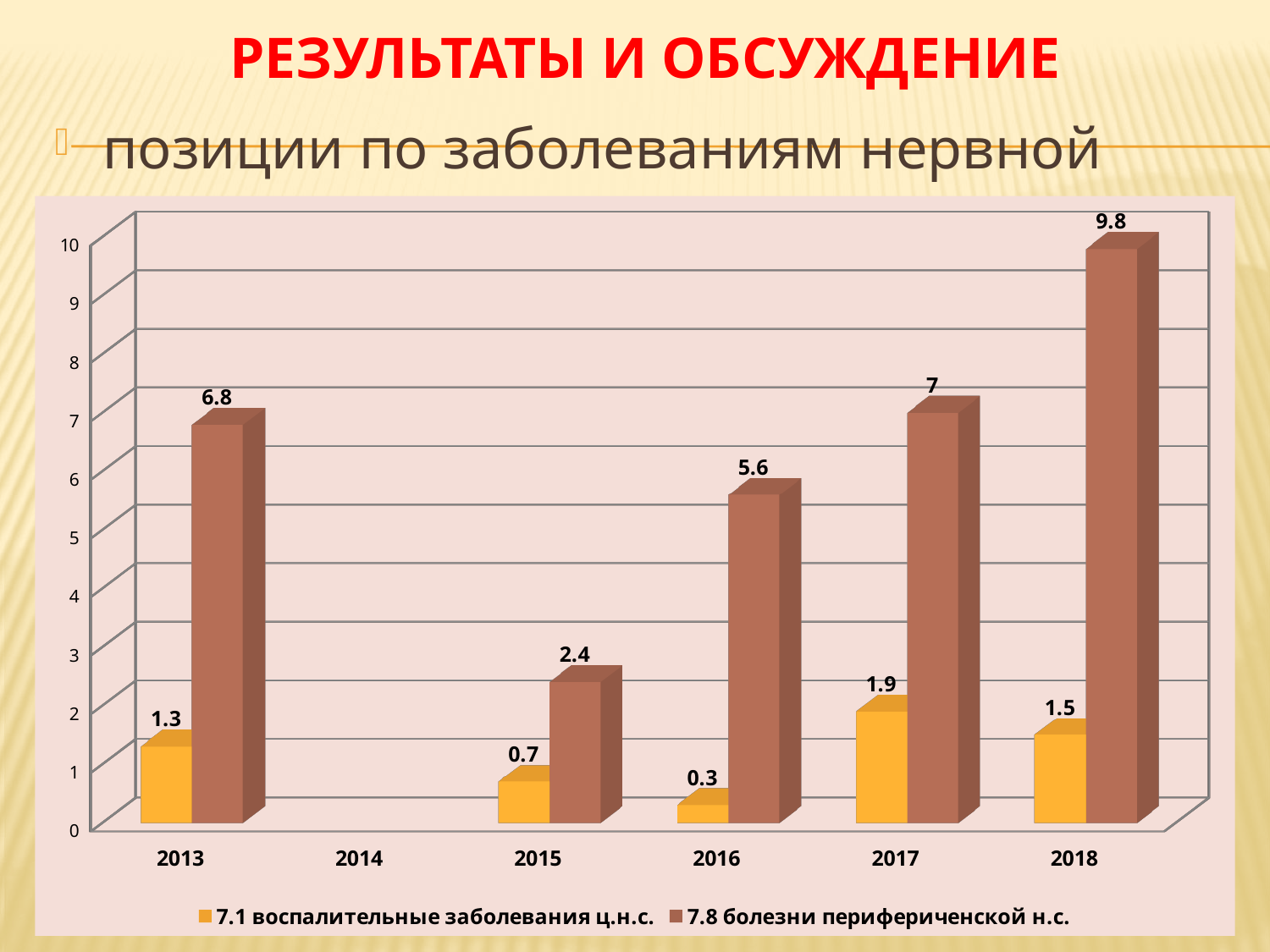
Which year on the x axis has no bars plotted? 2014 What is the difference between the 7.8 болезни перифериченской н.с. values for 2018 and 2017? 2.8 How many years are labelled on the x axis? 6 What is the value for 7.8 болезни перифериченской н.с. in 2016? 5.6 How many series does the legend list? 2 What is the value for 7.8 болезни перифериченской н.с. in 2018? 9.8 What is the value for 7.8 болезни перифериченской н.с. in 2015? 2.4 Which is larger: the 7.1 воспалительные заболевания ц.н.с. value in 2017 or in 2018? 2017 What kind of chart is shown on the slide? Bar chart What is the value for 7.1 воспалительные заболевания ц.н.с. in 2013? 1.3 In which year is the value for 7.1 воспалительные заболевания ц.н.с. the lowest? 2016 In which year is the value for 7.8 болезни перифериченской н.с. the highest? 2018